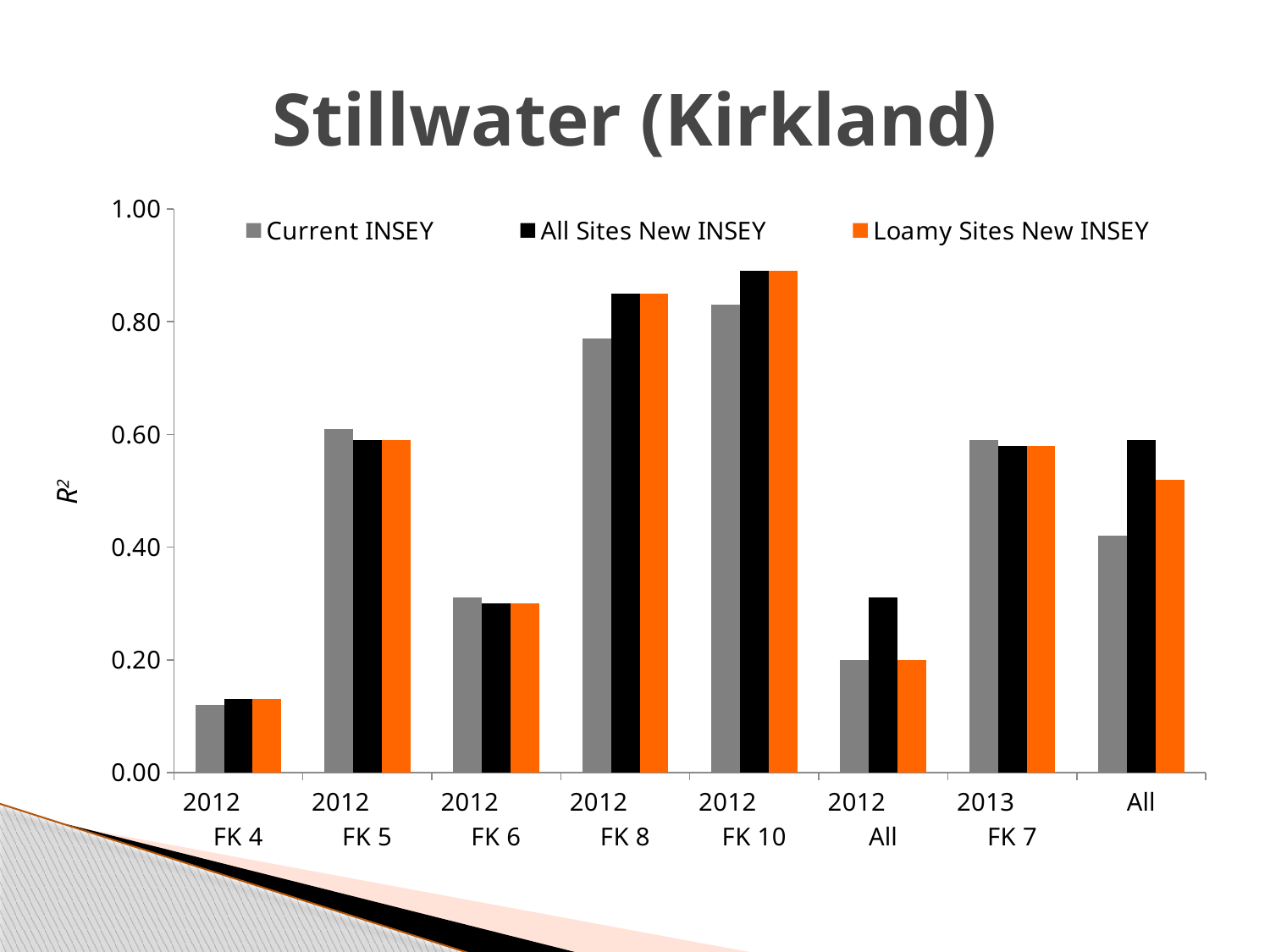
Is the All Sites New INSEY value for 2012 All greater or less than 0.20? greater Which category has the highest Current INSEY value? 2012 FK 10 For 2012 FK 8, which is larger: Current INSEY or Loamy Sites New INSEY? Loamy Sites New INSEY How many series does the legend list? 3 Is the Current INSEY value for 2012 FK 4 greater or less than 0.20? less Which category has the lowest All Sites New INSEY value? 2012 FK 4 What is the title of the chart? Stillwater (Kirkland) Is the Current INSEY value for 2012 FK 8 greater or less than 0.60? greater How many categories are shown on the x axis? 8 For the All category, which is larger: Current INSEY or All Sites New INSEY? All Sites New INSEY What kind of chart is shown on the slide? bar chart